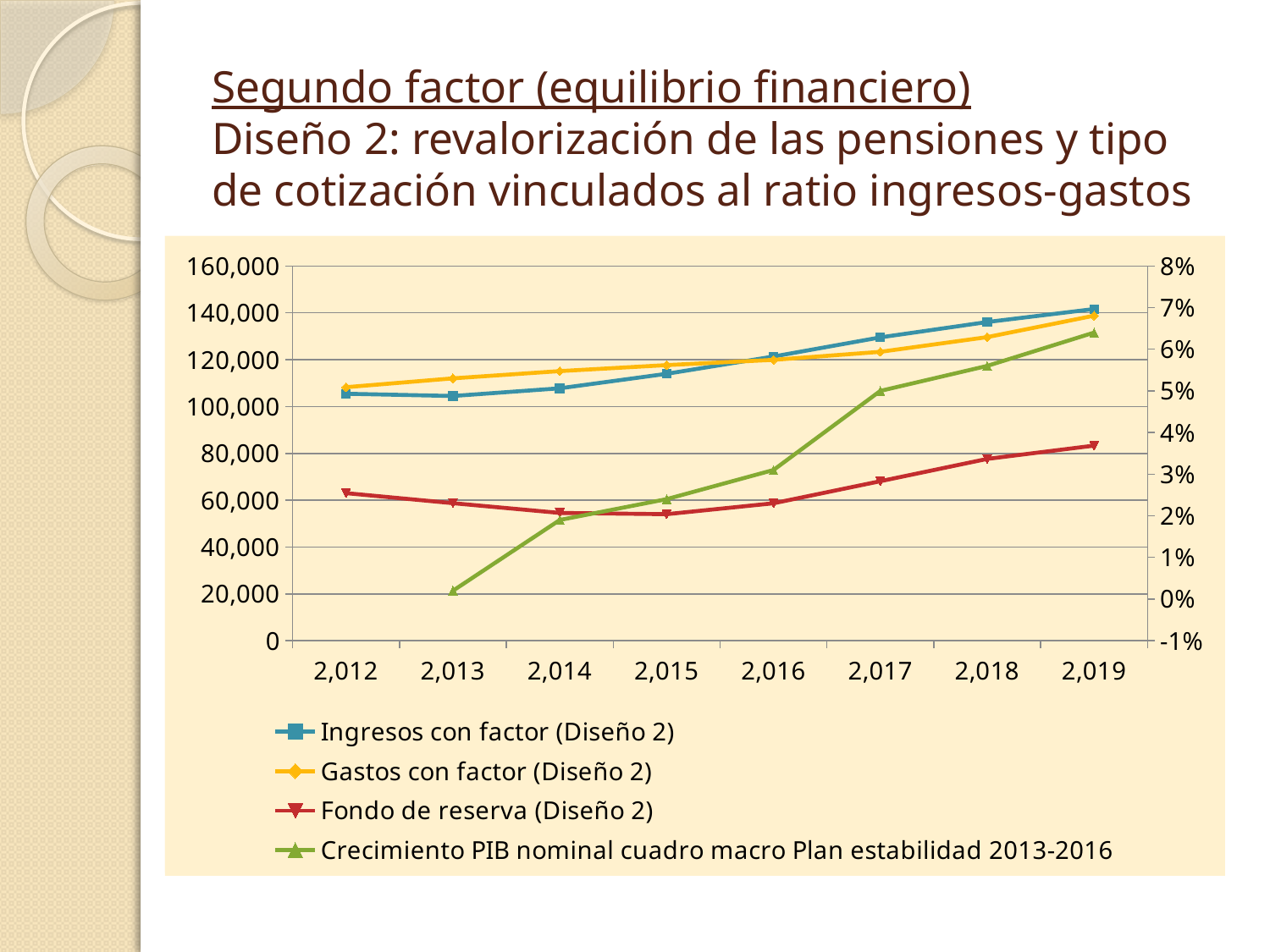
Does the Crecimiento PIB nominal series rise or fall from 2013 to 2019? rise Is the value for Crecimiento PIB nominal in 2013 greater or less than 1%? less In 2013, which is larger: Ingresos con factor (Diseño 2) or Gastos con factor (Diseño 2)? Gastos con factor (Diseño 2) Does the Ingresos con factor (Diseño 2) series rise or fall between 2013 and 2019? rise How many years are shown along the x axis? 8 What kind of chart is shown on the slide? line chart Is the value for Fondo de reserva (Diseño 2) in 2015 greater or less than 60,000? less In which year is the Fondo de reserva (Diseño 2) series at its highest? 2019 Is the value for Gastos con factor (Diseño 2) in 2012 greater or less than 100,000? greater How many series does the legend list? 4 In 2018, which is larger: Ingresos con factor (Diseño 2) or Gastos con factor (Diseño 2)? Ingresos con factor (Diseño 2)